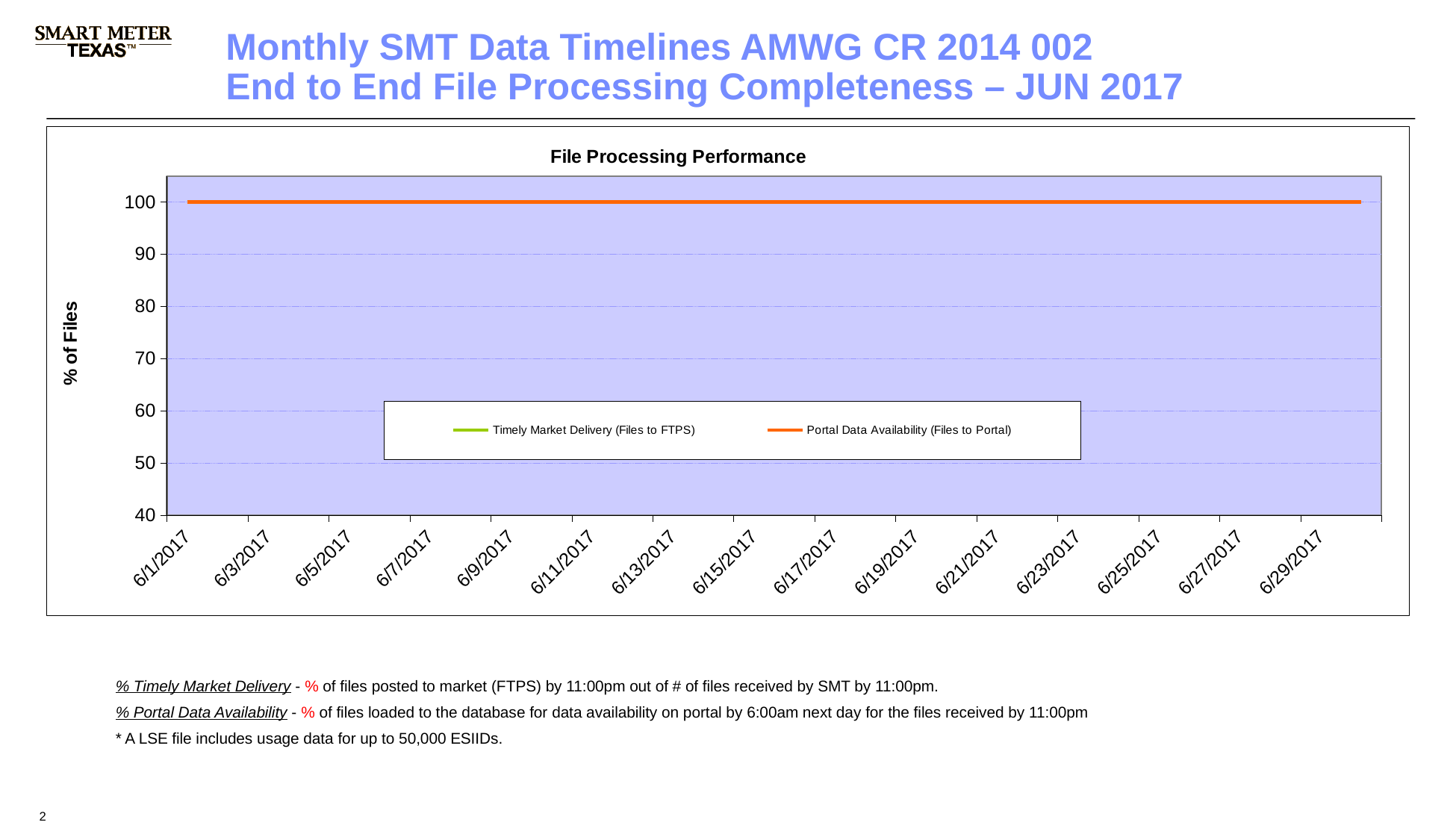
What is the lowest value shown on the y-axis of the chart? 40 What is the title of the chart? File Processing Performance Does the Portal Data Availability (Files to Portal) line rise, fall, or stay flat across June 2017? stays flat What are the two series named in the chart legend? Timely Market Delivery (Files to FTPS) and Portal Data Availability (Files to Portal) How many series does the chart legend list? 2 What value does the Portal Data Availability (Files to Portal) line sit at on 6/15/2017? 100 Is the value for Portal Data Availability (Files to Portal) on 6/21/2017 greater or less than 90? greater What kind of chart is shown on the slide? line chart What is the first date shown on the x-axis of the chart? 6/1/2017 What is the last date label shown on the x-axis of the chart? 6/29/2017 What value does the Portal Data Availability (Files to Portal) line sit at on 6/1/2017? 100